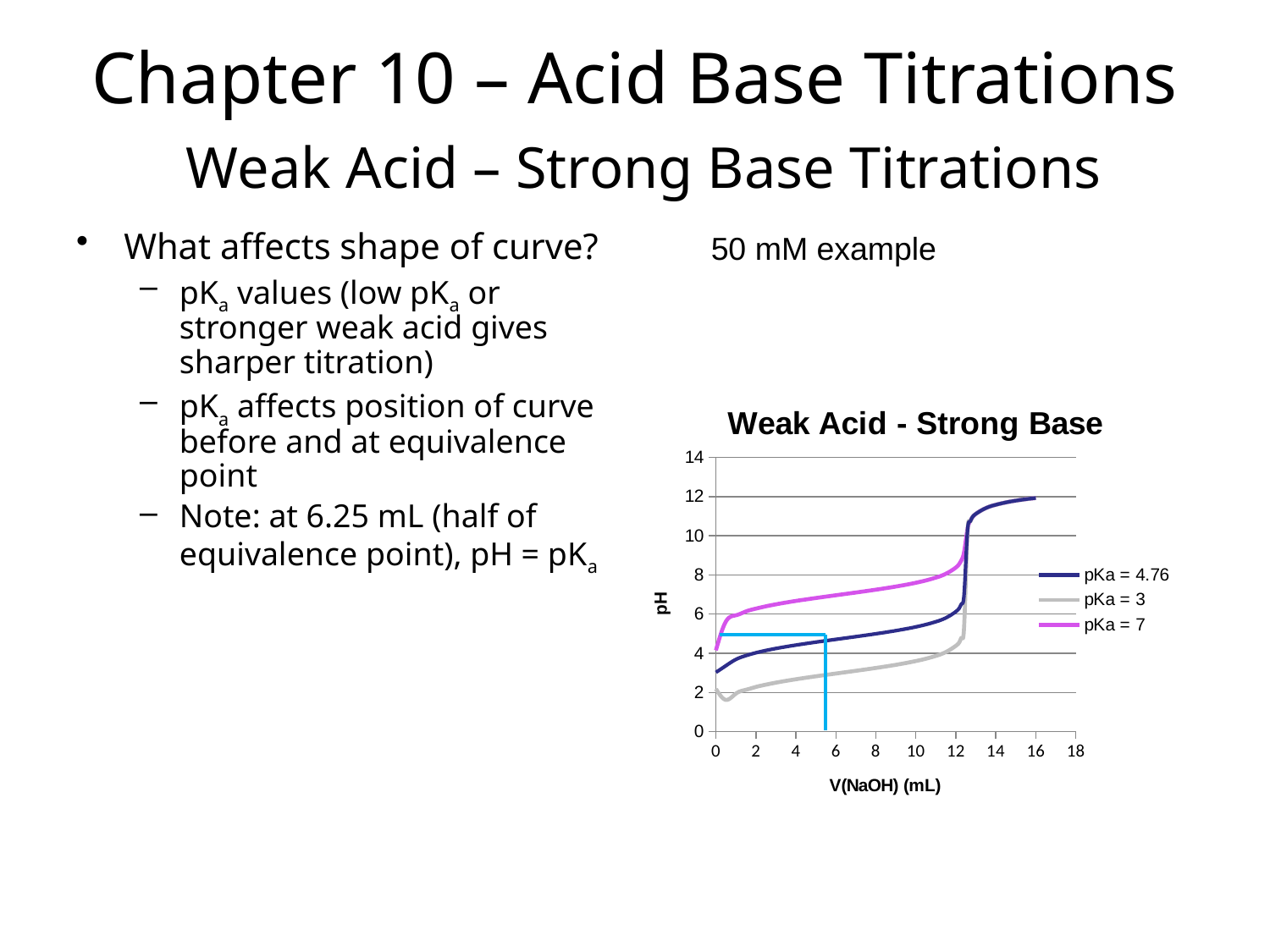
At V(NaOH) = 4 mL, is the pH for the pKa = 3 series greater or less than 4? less What is the highest value shown on the pH axis of the chart? 14 At V(NaOH) = 8 mL, is the pH for the pKa = 7 series greater or less than 6? greater What is the label of the x axis of the chart? V(NaOH) (mL) At V(NaOH) = 6 mL, which series has the higher pH, pKa = 7 or pKa = 3? pKa = 7 At V(NaOH) = 16 mL, is the pH for the pKa = 4.76 series greater or less than 10? greater How many series does the legend of the chart list? 3 What is the title of the chart? Weak Acid - Strong Base What kind of chart is shown on the slide? line chart Does the pH for the pKa = 7 series rise or fall as V(NaOH) increases? rise At V(NaOH) = 2 mL, which series has the lowest pH? pKa = 3